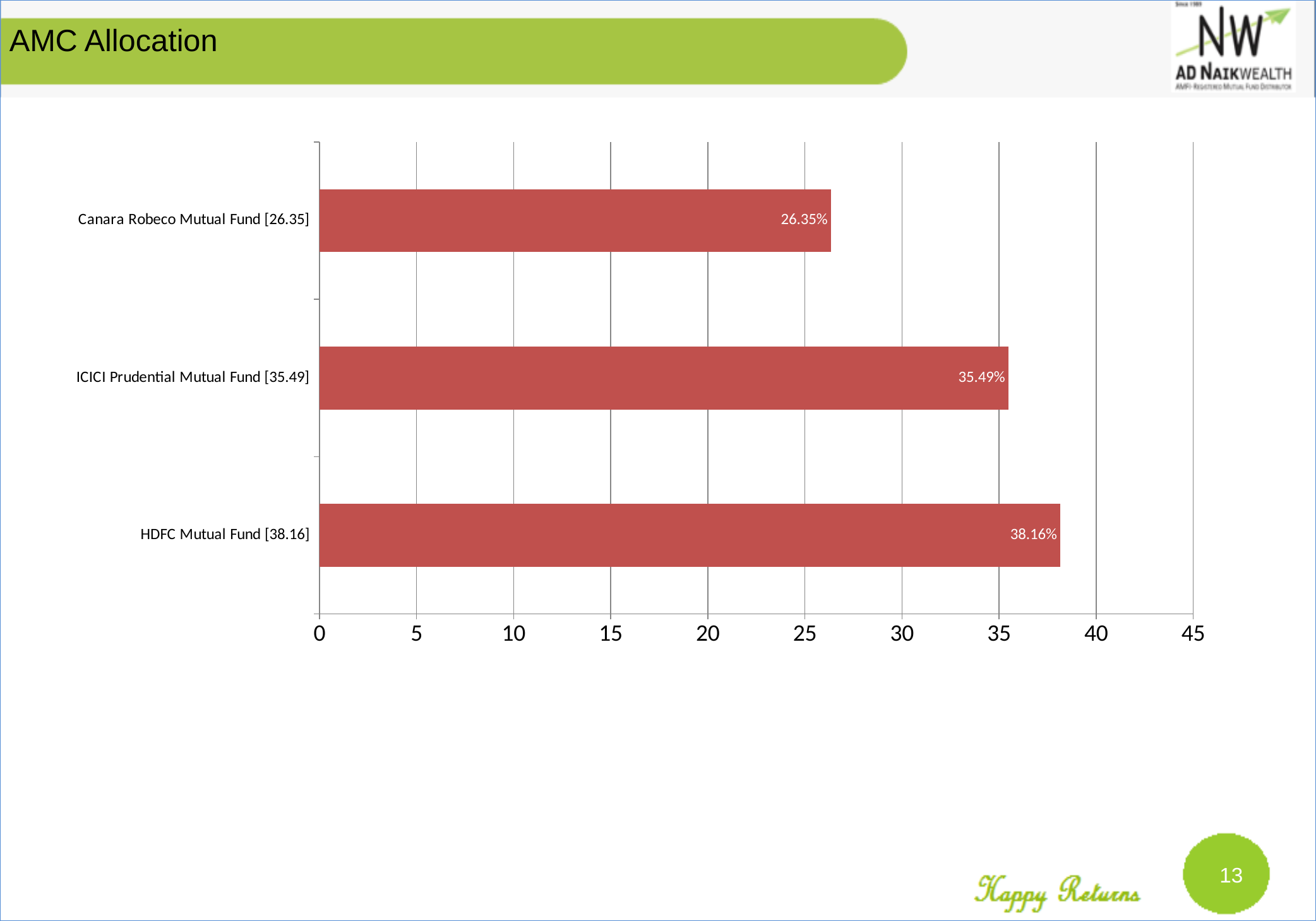
Which fund has the highest allocation? HDFC Mutual Fund What is the value for ICICI Prudential Mutual Fund? 35.49% What is the title of the slide? AMC Allocation How many funds are shown in the chart? 3 What is the difference between the values for ICICI Prudential Mutual Fund and Canara Robeco Mutual Fund? 9.14% What kind of chart is shown on the slide? bar chart What is the value for HDFC Mutual Fund? 38.16% Which is larger, the value for ICICI Prudential Mutual Fund or Canara Robeco Mutual Fund? ICICI Prudential Mutual Fund What is the value for Canara Robeco Mutual Fund? 26.35% What is the difference between the values for HDFC Mutual Fund and Canara Robeco Mutual Fund? 11.81% Which fund has the lowest allocation? Canara Robeco Mutual Fund Is the value for Canara Robeco Mutual Fund greater or less than 30? less